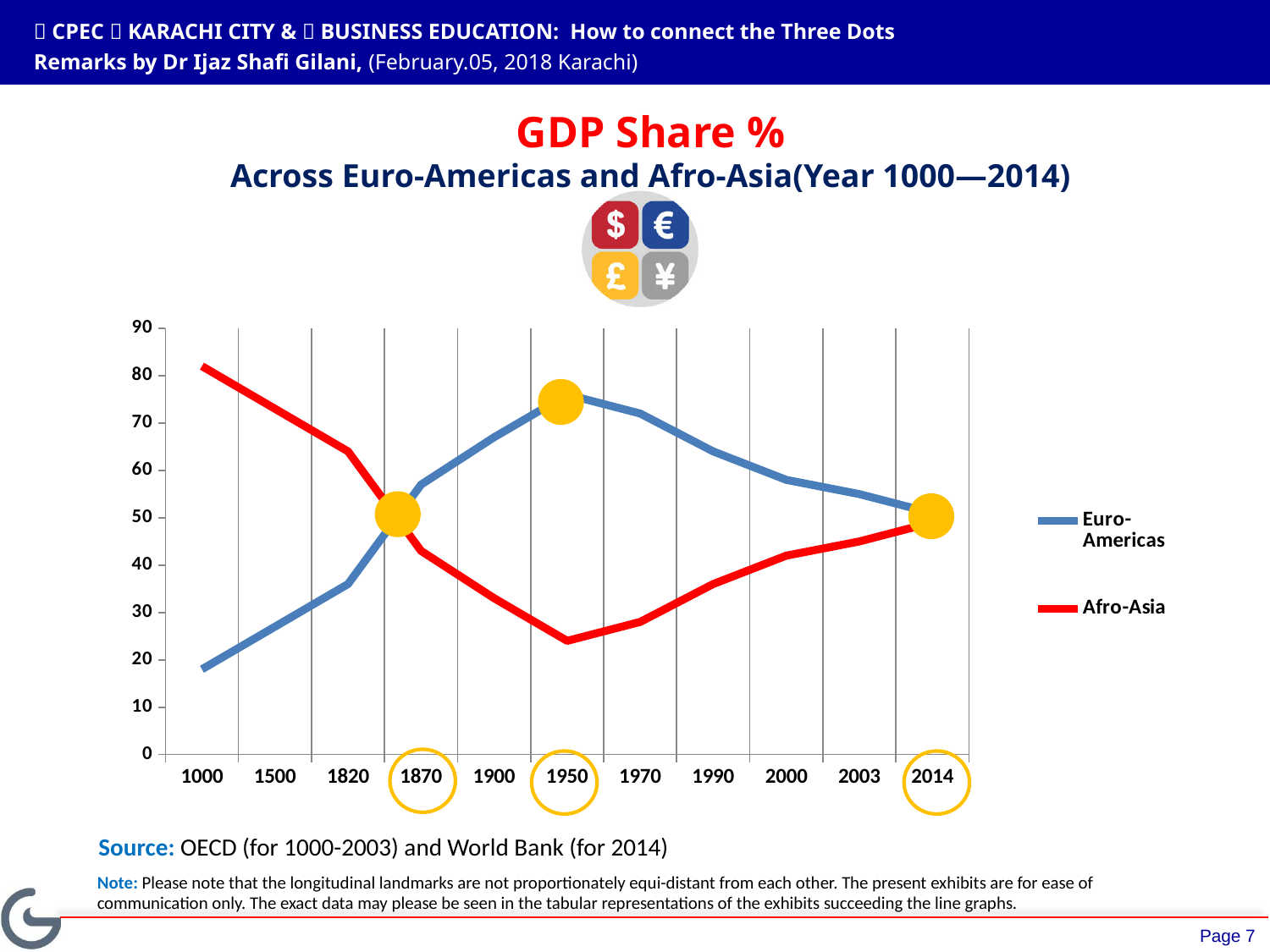
Is the value for Afro-Asia in 1950 greater or less than 30? less Is the value for Euro-Americas in 1950 greater or less than 60? greater In 1950, which series has the higher GDP share, Euro-Americas or Afro-Asia? Euro-Americas Does the Afro-Asia series rise or fall from the year 1000 to 1950? Fall In which year does the Euro-Americas series reach its highest value? 1950 Is the value for Euro-Americas in the year 1000 greater or less than 30? less How many years are marked along the x axis? 11 In the year 1000, which series has the higher GDP share, Euro-Americas or Afro-Asia? Afro-Asia How many series does the legend list? 2 What kind of chart is shown on the slide? Line chart In which year does the Afro-Asia series reach its lowest value? 1950